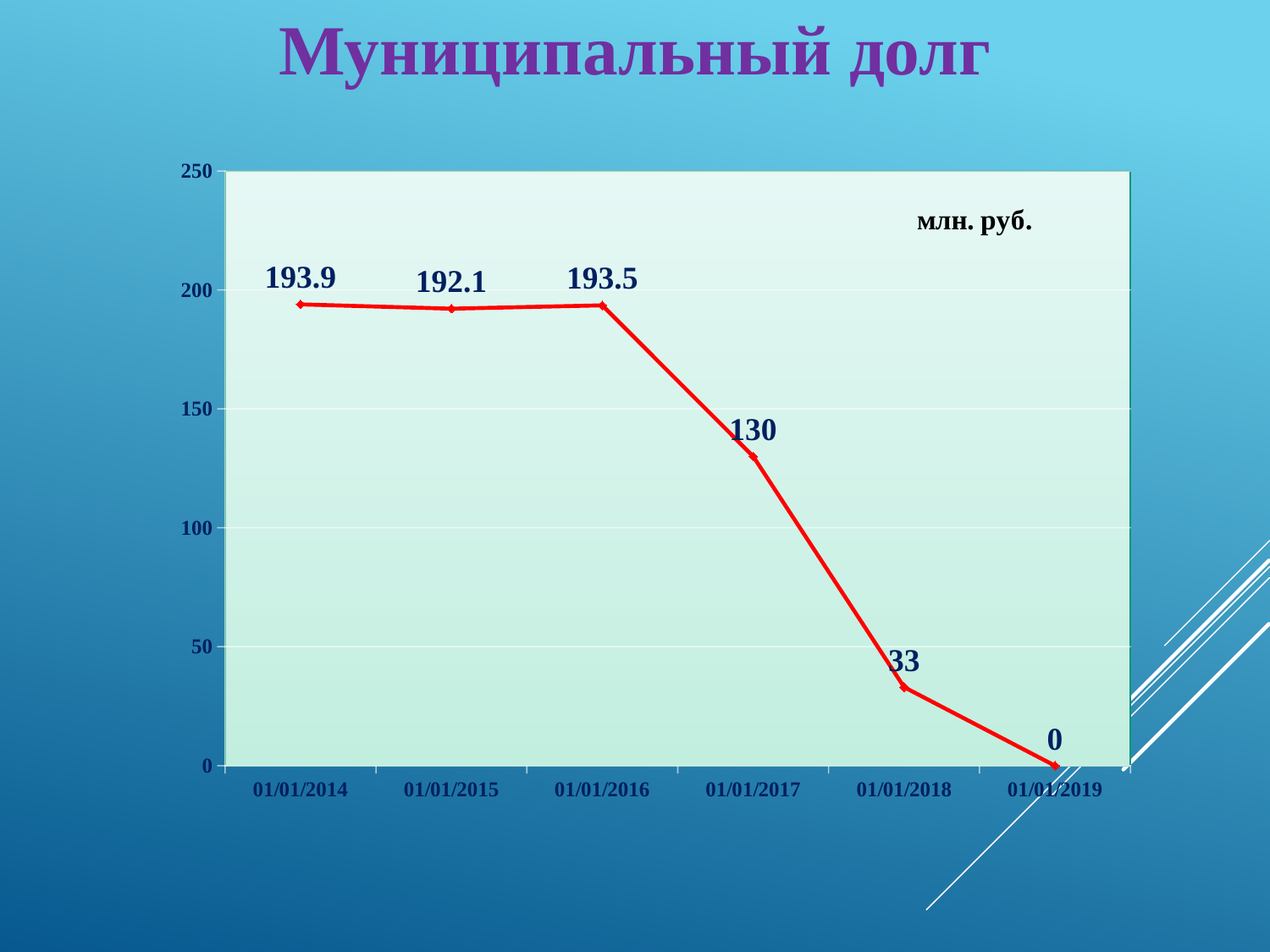
How many data points are plotted on the chart? 6 Do the values rise or fall from 01/01/2016 to 01/01/2019? fall Which is larger, the value on 01/01/2016 or the value on 01/01/2018? 01/01/2016 On which date is the municipal debt highest? 01/01/2014 On which date is the municipal debt lowest? 01/01/2019 What is the municipal debt value on 01/01/2018? 33 What is the municipal debt value on 01/01/2017? 130 What is the difference between the values on 01/01/2017 and 01/01/2018? 97 What is the municipal debt value on 01/01/2019? 0 What kind of chart is shown on the slide? line chart What is the municipal debt value on 01/01/2014? 193.9 What is the difference between the values on 01/01/2016 and 01/01/2017? 63.5